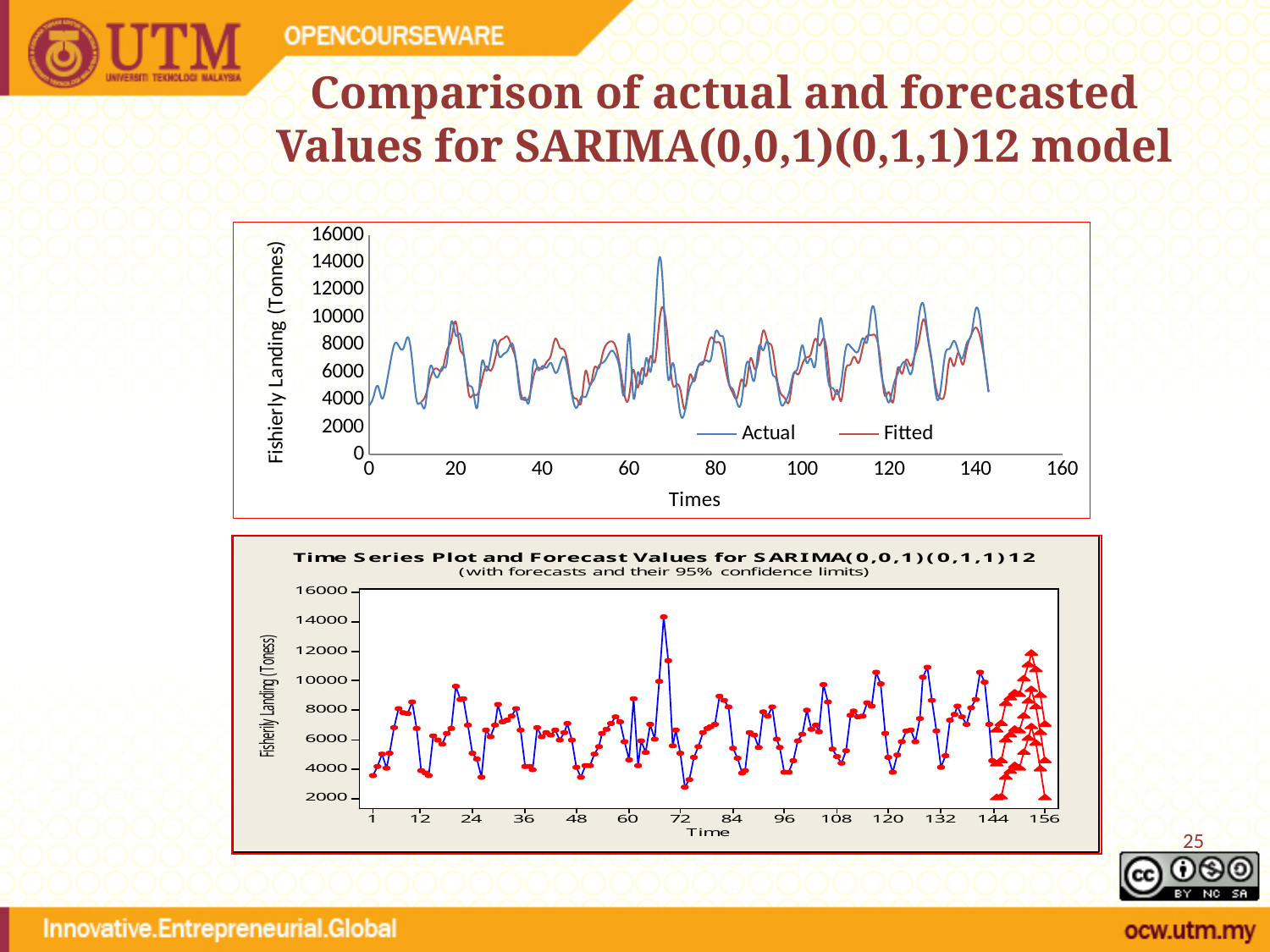
In the bottom chart, what is the largest tick value shown on the y axis? 16000 In the bottom chart, is the lowest plotted value near time 72 greater or less than 4000? less In the bottom chart, is the highest plotted value greater or less than 12000? greater In the top chart, is the Actual value at time 0 greater or less than 6000? less What kind of chart is the top chart on the slide? line chart In the top chart, what is the label of the x axis? Times In the bottom chart, what is the largest tick value shown on the x axis? 156 How many series does the legend of the top chart list? 2